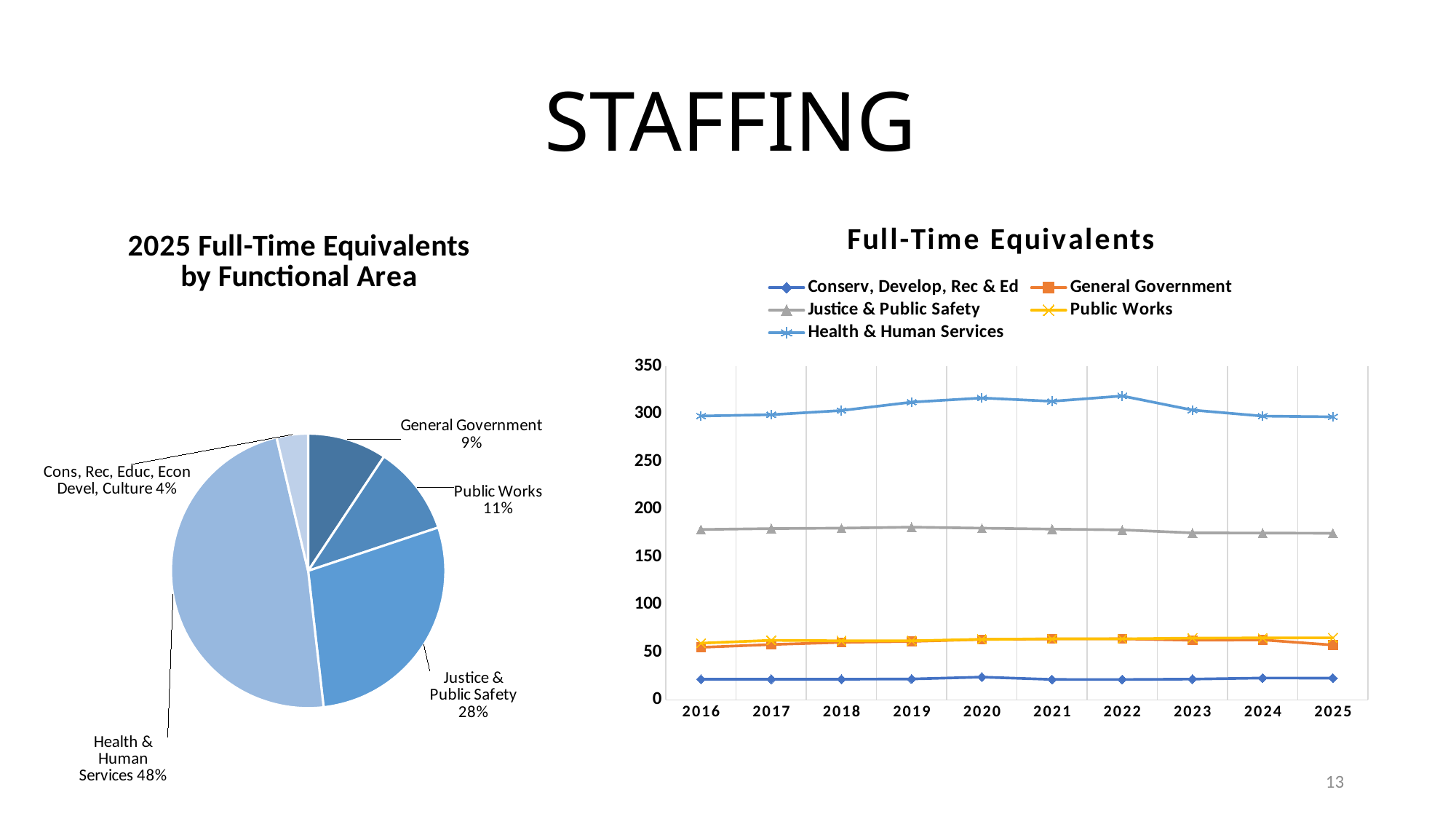
In the pie chart '2025 Full-Time Equivalents by Functional Area', what share does Justice & Public Safety have? 28% In the pie chart '2025 Full-Time Equivalents by Functional Area', which is larger: Public Works or General Government? Public Works In the 'Full-Time Equivalents' line chart, is the value for Justice & Public Safety in 2025 greater or less than 200? less In the pie chart '2025 Full-Time Equivalents by Functional Area', which functional area has the smallest share? Cons, Rec, Educ, Econ Devel, Culture What kind of chart is the 'Full-Time Equivalents' chart on the right? Line chart In the 'Full-Time Equivalents' line chart, is the value for Health & Human Services in 2020 greater or less than 300? greater In the pie chart '2025 Full-Time Equivalents by Functional Area', what share does Health & Human Services have? 48% In the pie chart '2025 Full-Time Equivalents by Functional Area', which functional area has the largest share? Health & Human Services How many years are shown on the x axis of the 'Full-Time Equivalents' line chart? 10 How many series does the legend of the 'Full-Time Equivalents' line chart list? 5 In the pie chart '2025 Full-Time Equivalents by Functional Area', how many percentage points larger is Public Works than General Government? 2 How many slices does the pie chart '2025 Full-Time Equivalents by Functional Area' have? 5